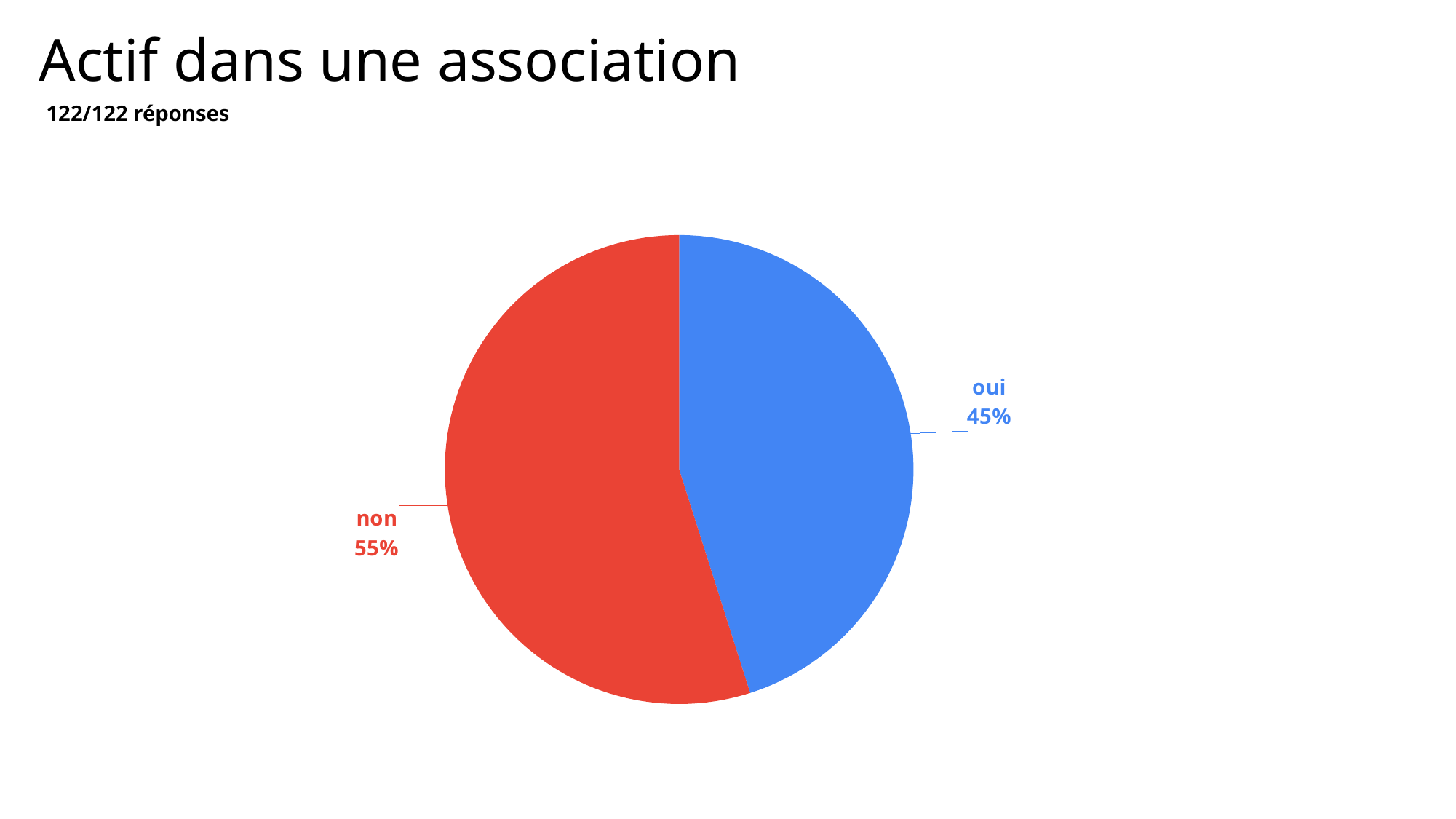
What share of the pie does the "non" slice represent? 55% What is the title of the slide? Actif dans une association What share of the pie does the "oui" slice represent? 45% Which is larger, the "oui" slice or the "non" slice? non How many responses does the slide report? 122/122 réponses Which slice is the largest? non What is the difference in percentage points between the "non" and "oui" slices? 10 How many slices does the pie chart have? 2 What kind of chart is shown on the slide? pie chart What colour is the "oui" slice? blue Which slice is the smallest? oui